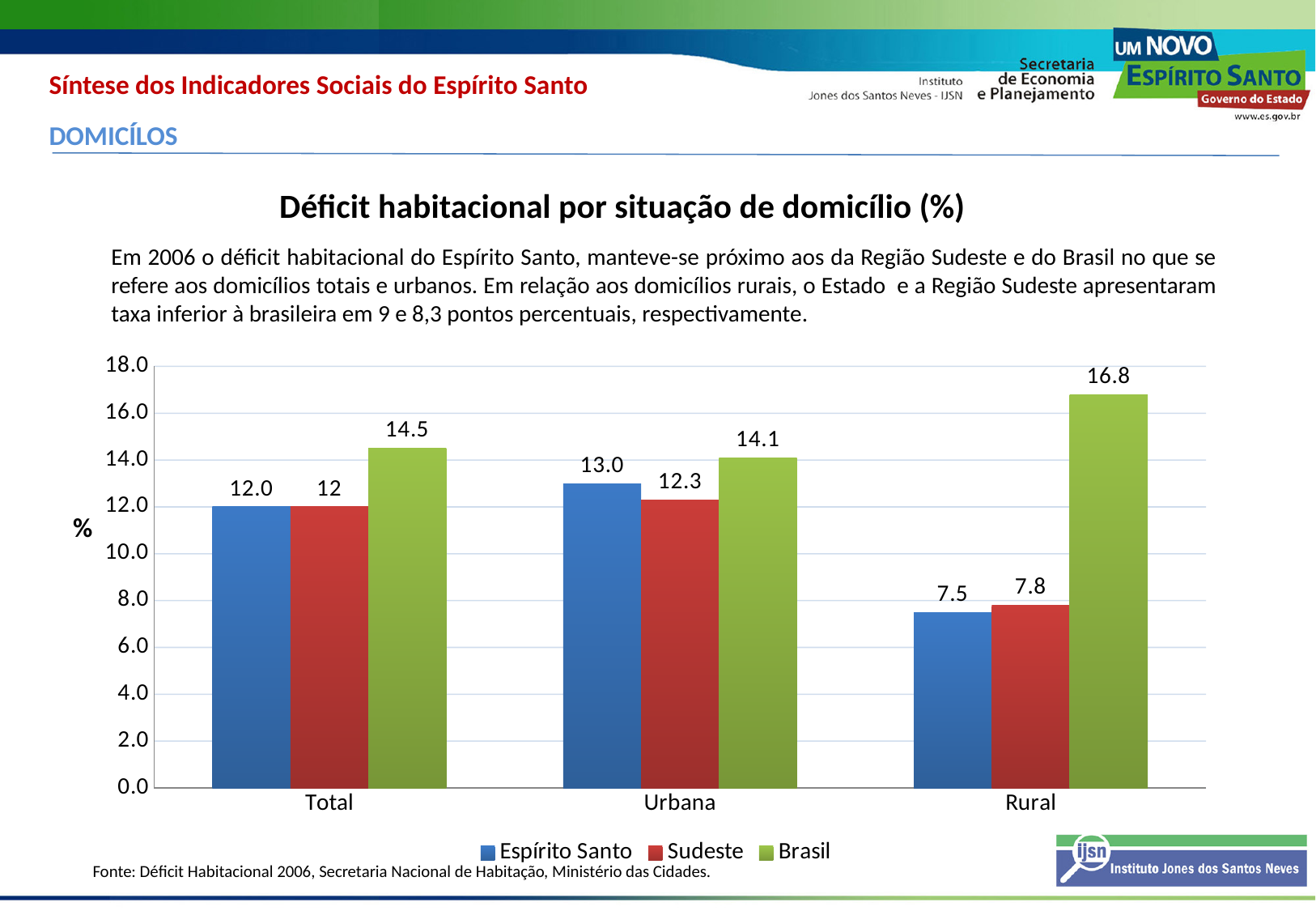
What is the value for Espírito Santo in the Urbana category? 13.0 Which is larger in the Urbana category: Espírito Santo or Sudeste? Espírito Santo How many categories are shown on the x axis? 3 Which series has the highest value in the Urbana category? Brasil What kind of chart is shown on the slide? Bar chart What is the title of the chart? Déficit habitacional por situação de domicílio (%) What is the value for Sudeste in the Total category? 12 What is the difference between the Brasil and Espírito Santo values in the Rural category? 9.3 How many series does the legend list? 3 What is the value for Brasil in the Rural category? 16.8 Which category has the lowest value for Espírito Santo? Rural Is the value for Brasil in the Total category greater or less than 14.0? greater